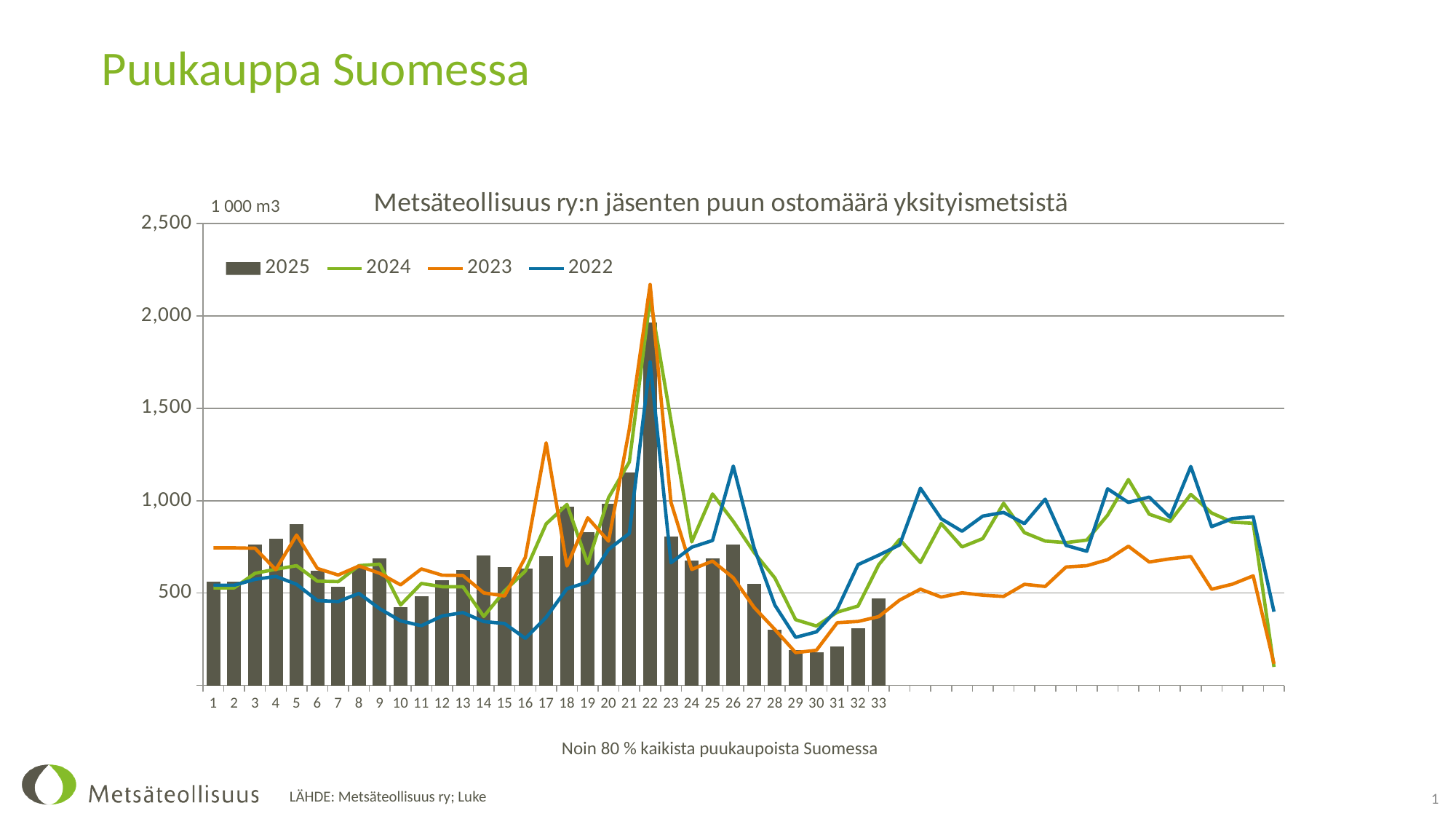
Which is larger, the 2025 value for week 5 or for week 7? Week 5 How many weeks have a 2025 bar plotted? 33 What is the title of the chart? Metsäteollisuus ry:n jäsenten puun ostomäärä yksityismetsistä Which series is drawn as bars rather than a line? 2025 Is the 2023 value for week 22 greater or less than 2,000? greater Do the 2025 bars rise or fall from week 22 to week 30? Fall What kind of chart is shown on the slide? A combined bar and line chart Is the 2025 value for week 22 greater or less than 1,500? greater At which week is the 2025 bar highest? 22 Is the 2025 value for week 29 greater or less than 500? less How many series does the legend list? 4